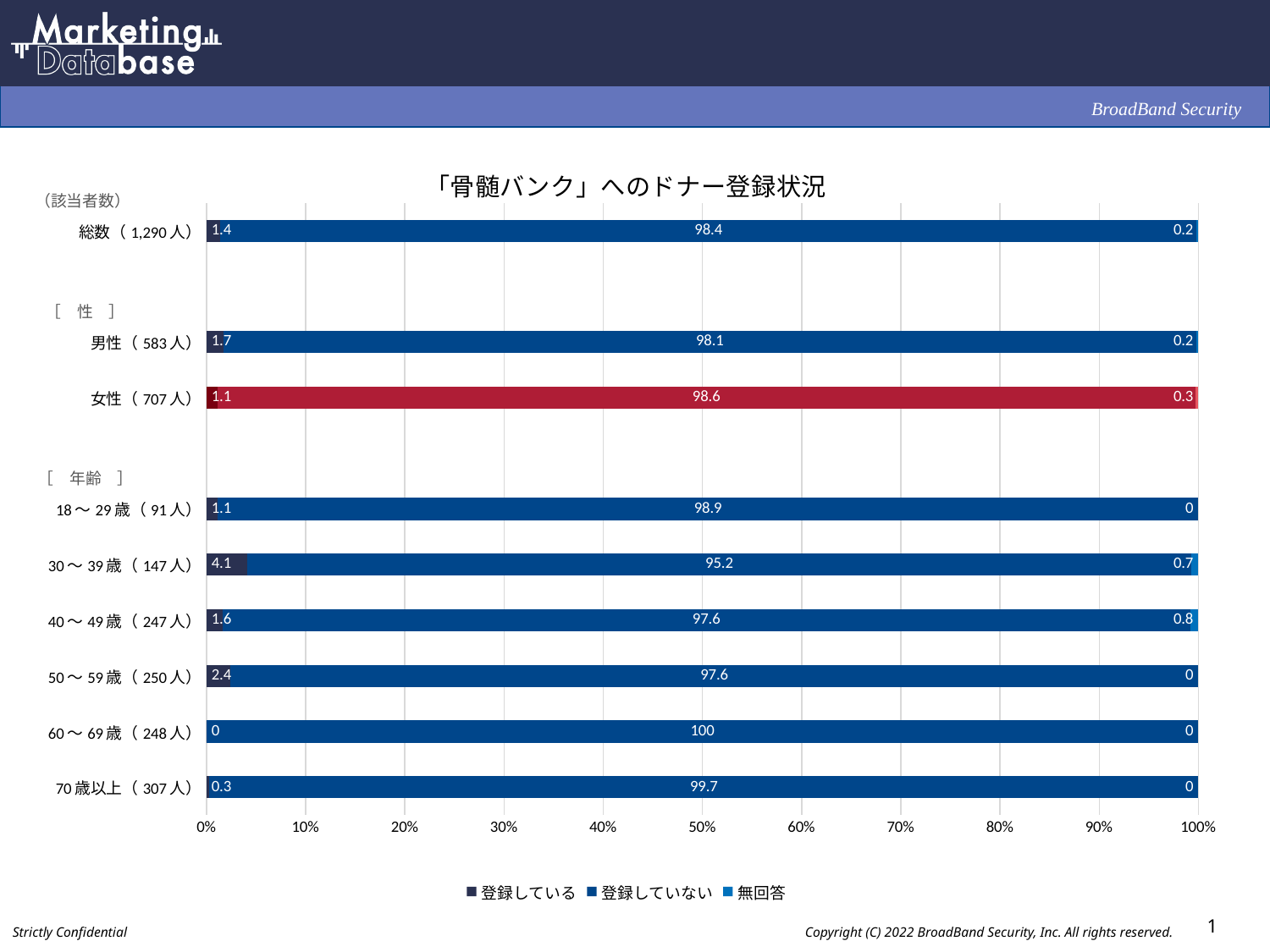
What is the value of 登録している for 30～39歳 (147人)? 4.1 What kind of chart is shown on the slide? Stacked bar chart What is the value of 登録していない for 60～69歳 (248人)? 100 Which category has the highest value for 登録している? 30～39歳 (147人) Which category has the lowest value for 登録していない? 30～39歳 (147人) What is the title of the chart? 「骨髄バンク」へのドナー登録状況 What is the difference between the 登録している values for 50～59歳 (250人) and 18～29歳 (91人)? 1.3 How many series does the legend list? 3 What is the value of 登録していない for 総数 (1,290人)? 98.4 What is the value of 無回答 for 女性 (707人)? 0.3 Which is larger, the 登録している value for 男性 (583人) or for 女性 (707人)? 男性 (583人) How many categories (bars) are plotted in the chart? 9